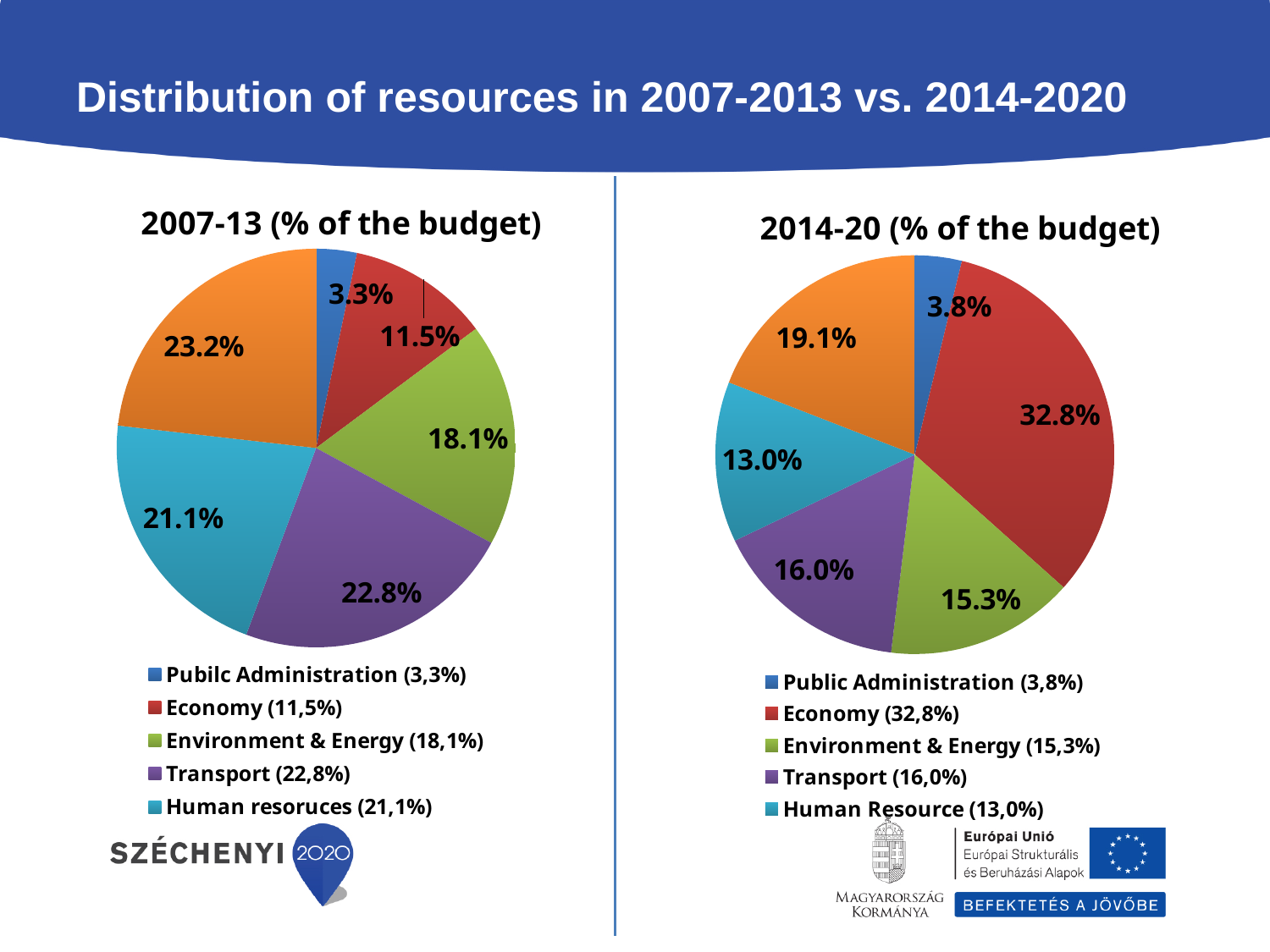
How many slices does the 2007-13 (% of the budget) pie chart have? 6 How many entries does the legend of the 2014-20 (% of the budget) pie chart list? 5 In the 2014-20 (% of the budget) pie chart, what percentage is shown for Economy? 32.8% Is the Transport share larger in the 2007-13 chart or the 2014-20 chart? 2007-13 In the 2014-20 (% of the budget) pie chart, which legend category has the largest slice? Economy In the 2007-13 (% of the budget) pie chart, what percentage is shown for Human resources? 21.1% In the 2014-20 (% of the budget) pie chart, what percentage is shown for Environment & Energy? 15.3% In the 2007-13 (% of the budget) pie chart, which category has the smallest slice? Public Administration In the 2007-13 (% of the budget) pie chart, what percentage is shown for Transport? 22.8% By how many percentage points is the Economy share in the 2014-20 chart larger than in the 2007-13 chart? 21.3 percentage points What type of chart is used on this slide for the 2007-13 and 2014-20 data? Pie chart In the 2014-20 (% of the budget) pie chart, what colour represents Economy? Red